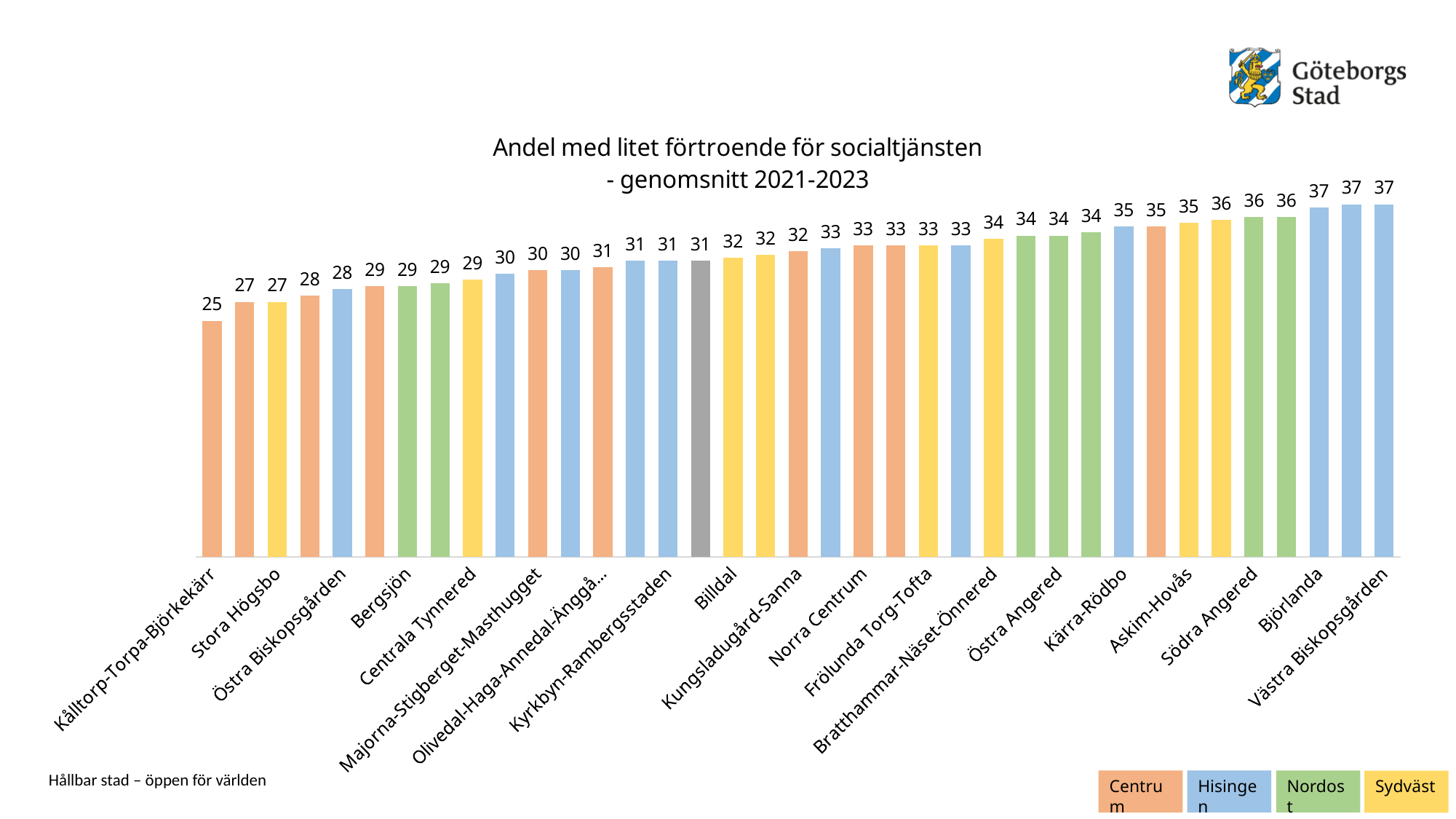
Which area has the lowest value in the chart? Kålltorp-Torpa-Björkekärr What is the value for Kålltorp-Torpa-Björkekärr? 25 What is the value for Bergsjön? 29 What kind of chart is shown on the slide? Bar chart Which has a larger value, Björlanda or Stora Högsbo? Björlanda What is the title of the chart? Andel med litet förtroende för socialtjänsten - genomsnitt 2021-2023 What is the difference between the values for Västra Biskopsgården and Kålltorp-Torpa-Björkekärr? 12 What is the value for Västra Biskopsgården? 37 What is the highest value shown in the chart? 37 Do the values rise or fall from left to right along the x axis? Rise What is the value for Billdal? 32 How many series does the legend list? 4